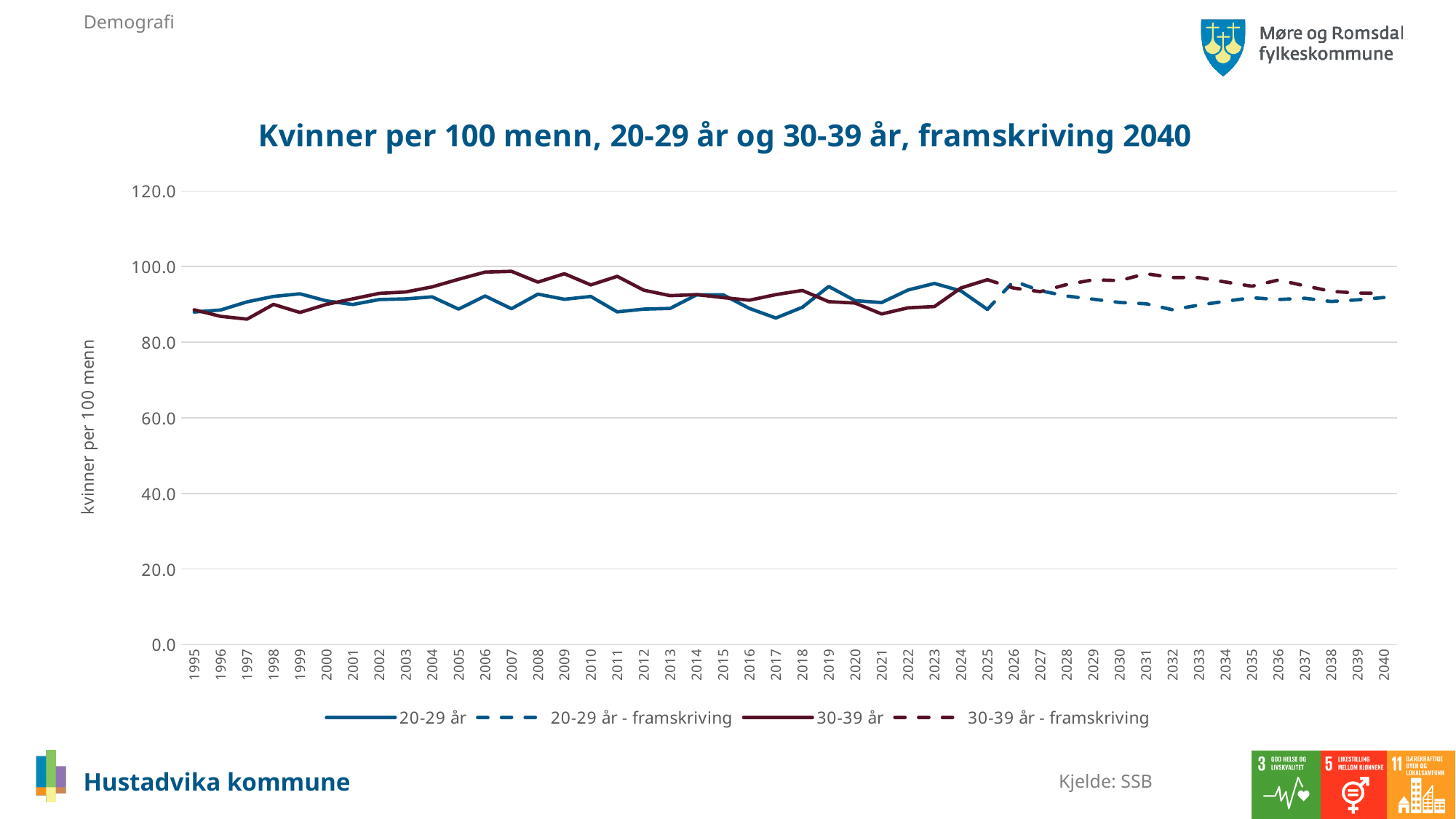
What kind of chart is shown on the slide? line chart Is the value for 20-29 år in 2017 greater or less than 80? greater Is the value for 30-39 år in 2007 greater or less than 80? greater What is the first year shown on the x axis? 1995 In 2007, which series has the higher value: 20-29 år or 30-39 år? 30-39 år In 2019, which series has the higher value: 20-29 år or 30-39 år? 20-29 år What is the label on the vertical axis? kvinner per 100 menn How many series does the legend list? 4 What is the title of the chart? Kvinner per 100 menn, 20-29 år og 30-39 år, framskriving 2040 Is the value for 30-39 år in 2007 greater or less than 100? less What is the last year shown on the x axis? 2040 In 2017, which series has the higher value: 20-29 år or 30-39 år? 30-39 år